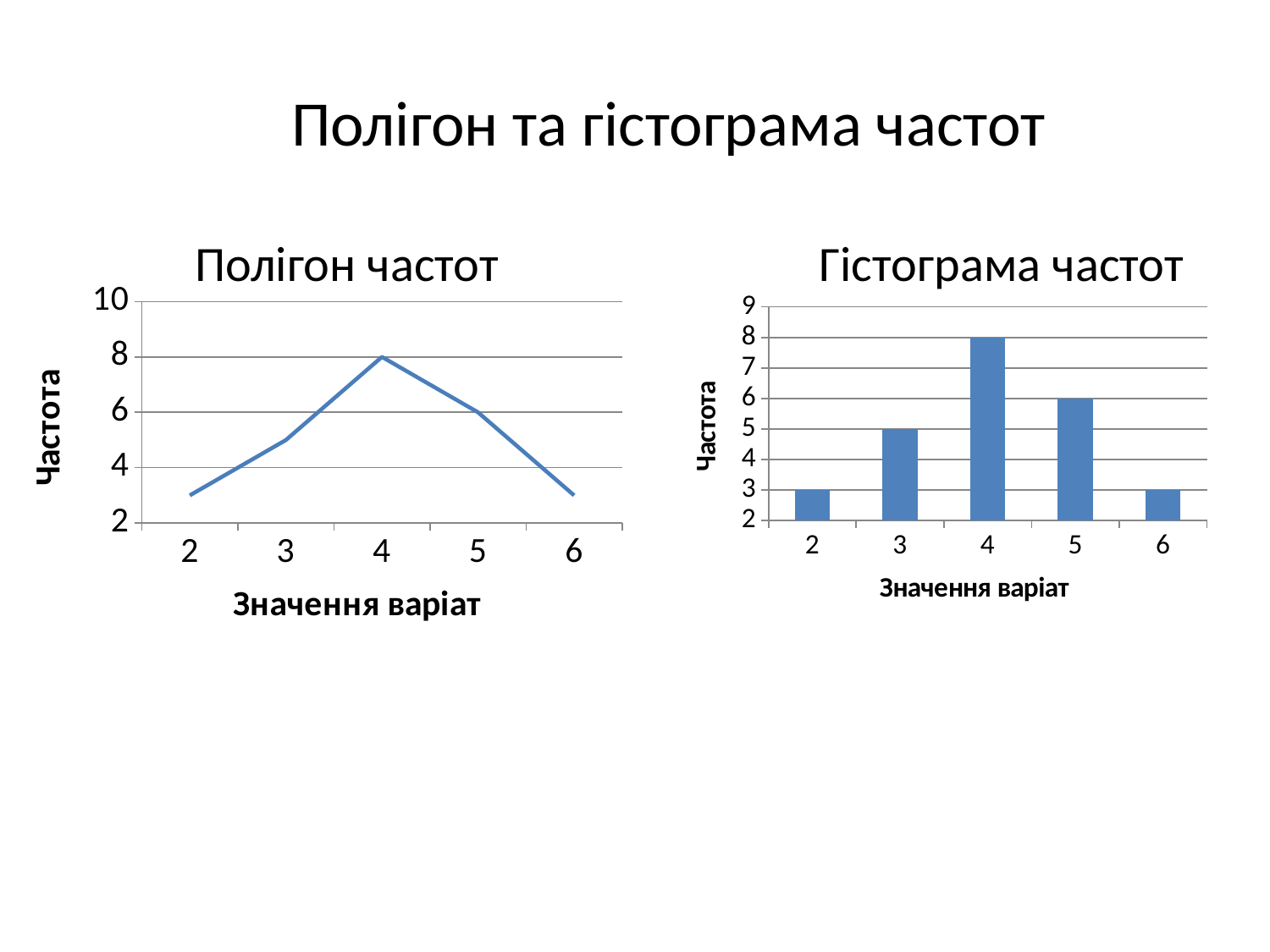
What kind of chart is the left chart titled "Полігон частот"? line chart In the chart "Гістограма частот", which value of "Значення варіат" has the highest frequency? 4 In the chart "Гістограма частот", what is the frequency for the value 3? 5 In the chart "Гістограма частот", what is the frequency for the value 4? 8 In the chart "Полігон частот", what is the frequency at the value 4? 8 In the chart "Гістограма частот", which has the larger frequency, value 3 or value 5? 5 How many bars are shown in the chart "Гістограма частот"? 5 What is the y-axis label of the chart "Гістограма частот"? Частота In the chart "Полігон частот", does the line rise or fall from the value 4 to the value 6? fall In the chart "Полігон частот", is the frequency at the value 2 greater or less than 4? less What kind of chart is the right chart titled "Гістограма частот"? bar chart In the chart "Гістограма частот", what is the difference between the frequencies for values 4 and 5? 2